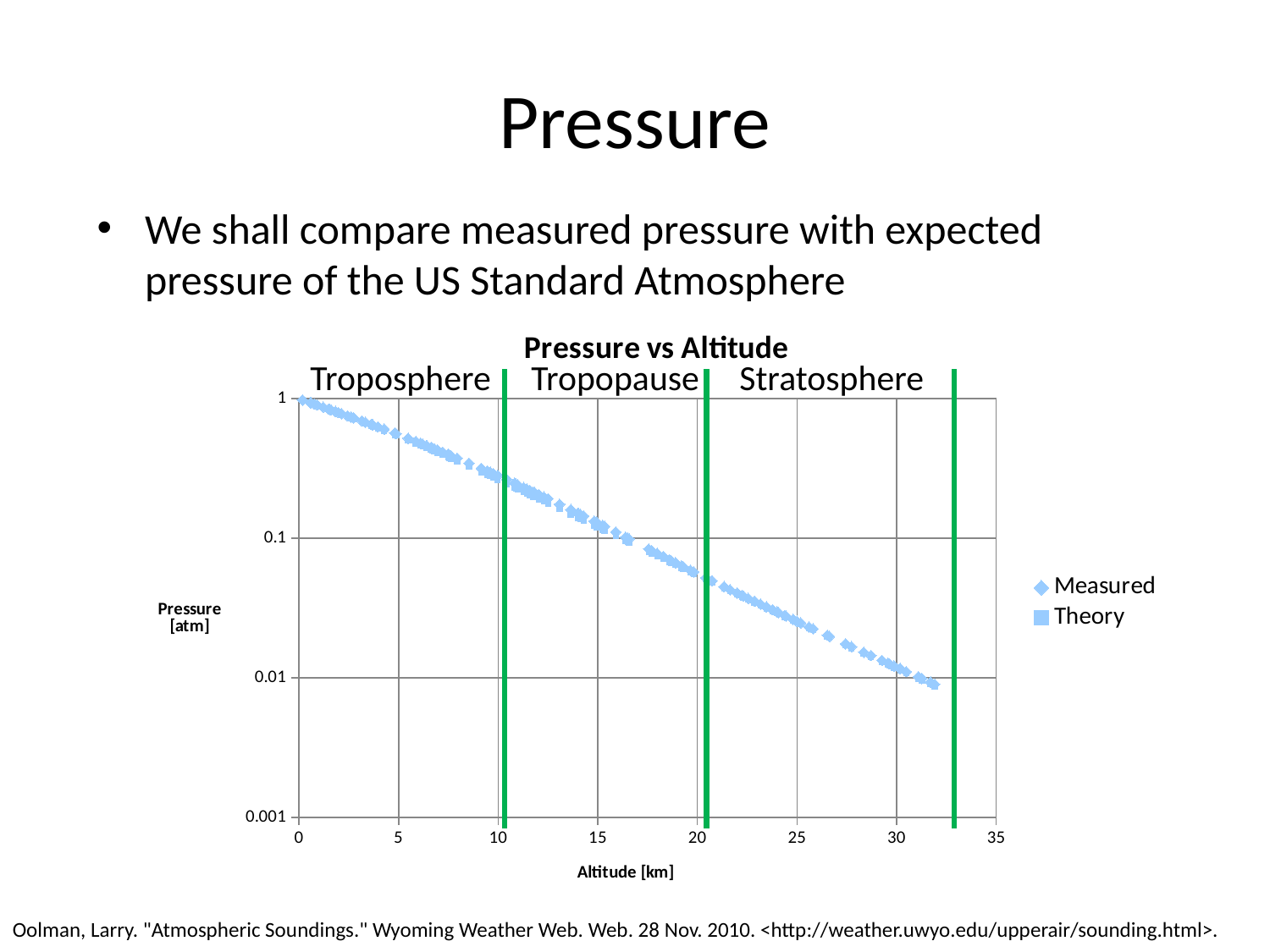
Is the pressure at an altitude of 5 km greater or less than 0.1 atm? greater What is the title of the chart? Pressure vs Altitude What kind of chart is shown on the slide? scatter chart What is the label of the x axis of the chart? Altitude [km] Which is larger, the pressure at 5 km or the pressure at 25 km? 5 km Does pressure rise or fall as altitude increases along the x axis? fall What is the highest altitude tick shown on the x axis? 35 How many series does the chart legend list? 2 Is the pressure at an altitude of 20 km greater or less than 0.1 atm? less Is the pressure at an altitude of 25 km greater or less than 0.01 atm? greater